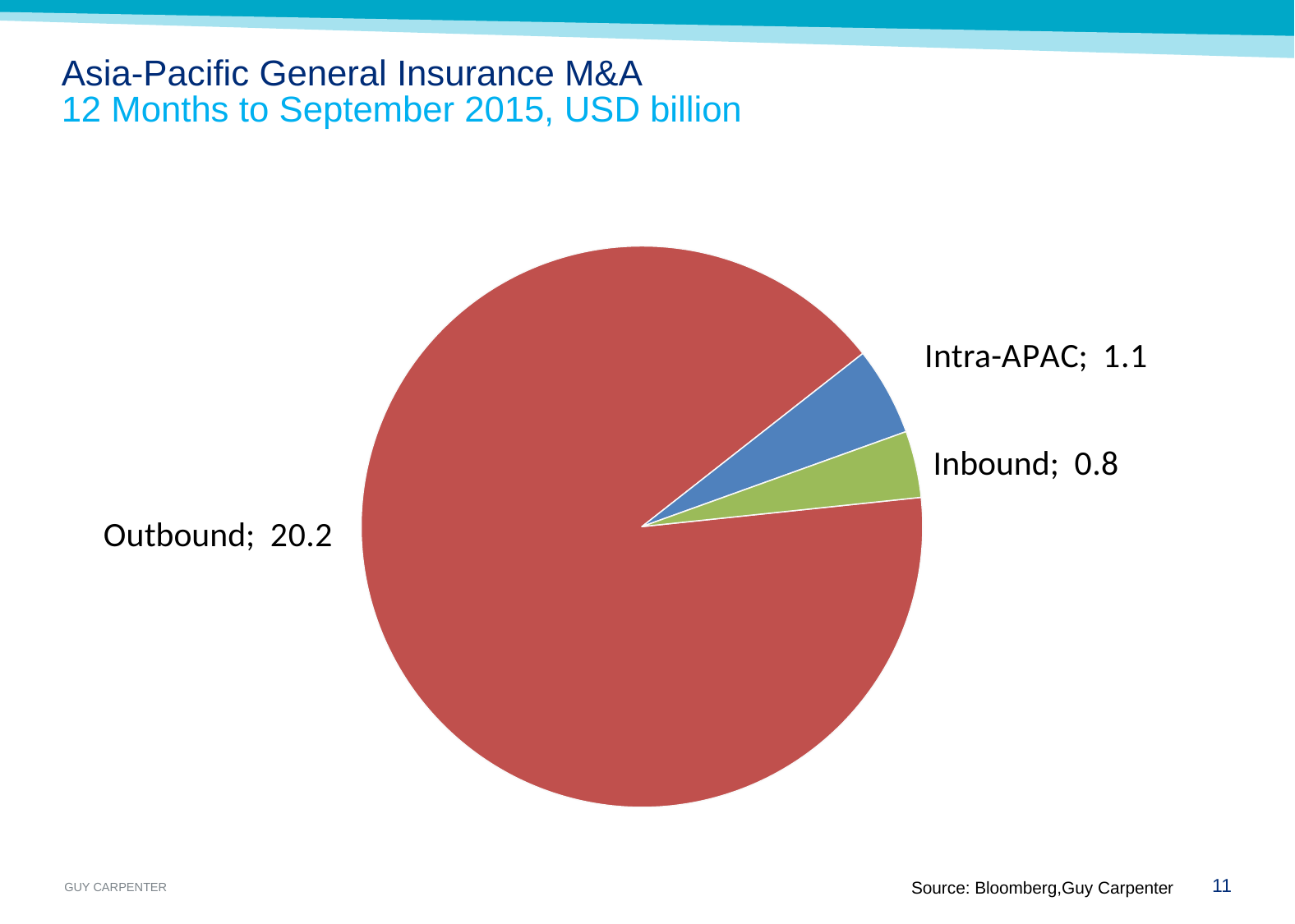
Which category has the smallest slice of the pie? Inbound What is the value for Outbound? 20.2 Which category has the largest slice of the pie? Outbound How many slices does the pie chart have? 3 What is the value for Intra-APAC? 1.1 What is the difference between the Intra-APAC and Inbound values? 0.3 What kind of chart is shown on the slide? pie chart What is the total of all three slices in the pie chart? 22.1 What is the value for Inbound? 0.8 Which is larger, Intra-APAC or Inbound? Intra-APAC What is the difference between the Outbound and Intra-APAC values? 19.1 What unit and period does the chart subtitle state? 12 Months to September 2015, USD billion